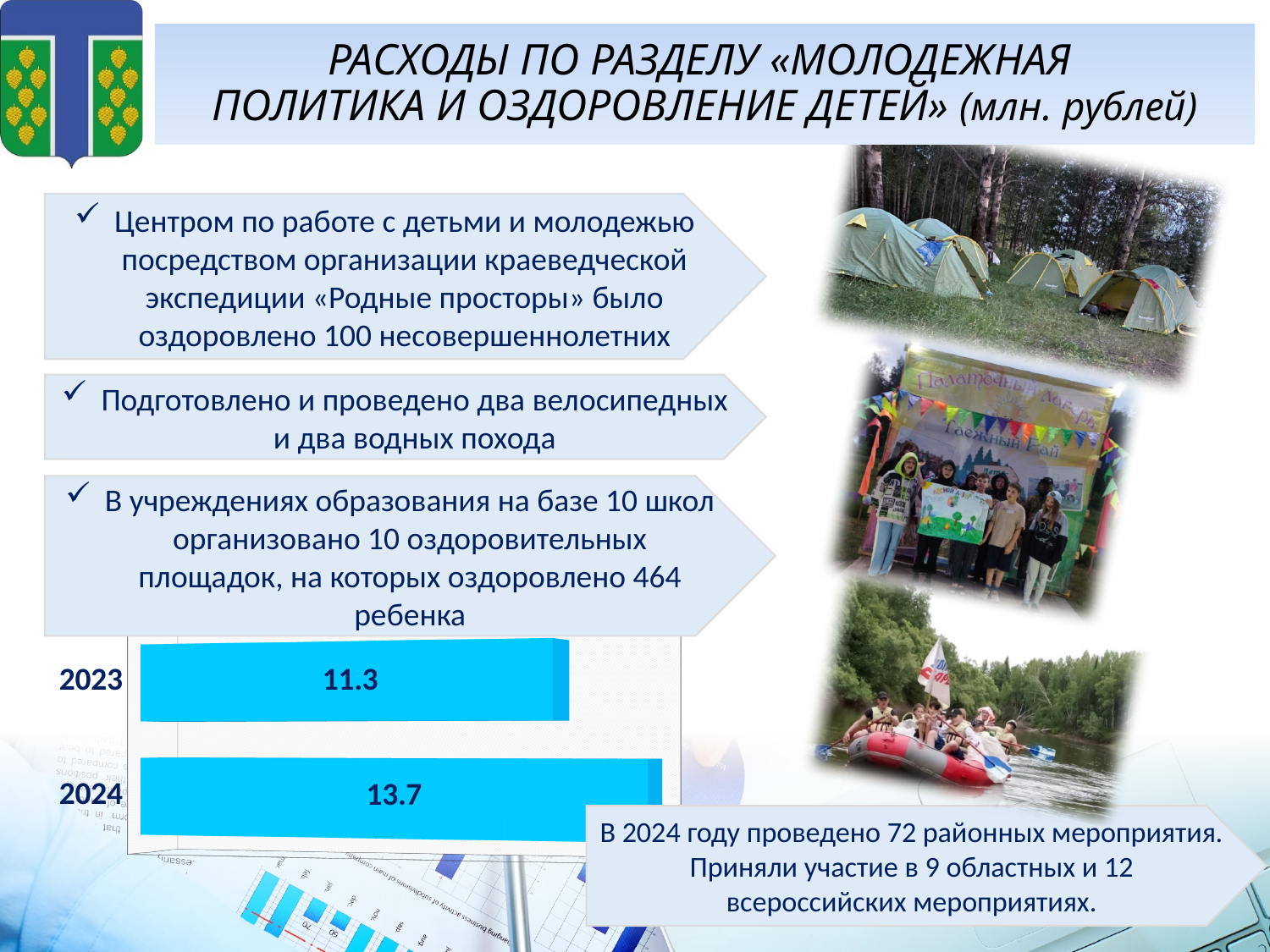
How many categories (years) are shown on the chart? 2 Which year has the lower value on the chart? 2023 What kind of chart is shown on the slide? bar chart Which year has the higher value on the chart? 2024 What colour are the bars on the chart? light blue What is the value for 2024 on the chart? 13.7 Do the values rise or fall from 2023 to 2024? rise What is the difference between the 2024 and 2023 values on the chart? 2.4 What is the value for 2023 on the chart? 11.3 What unit is given in the slide title for the chart values? млн. рублей Is the value for 2024 larger or smaller than the value for 2023? larger